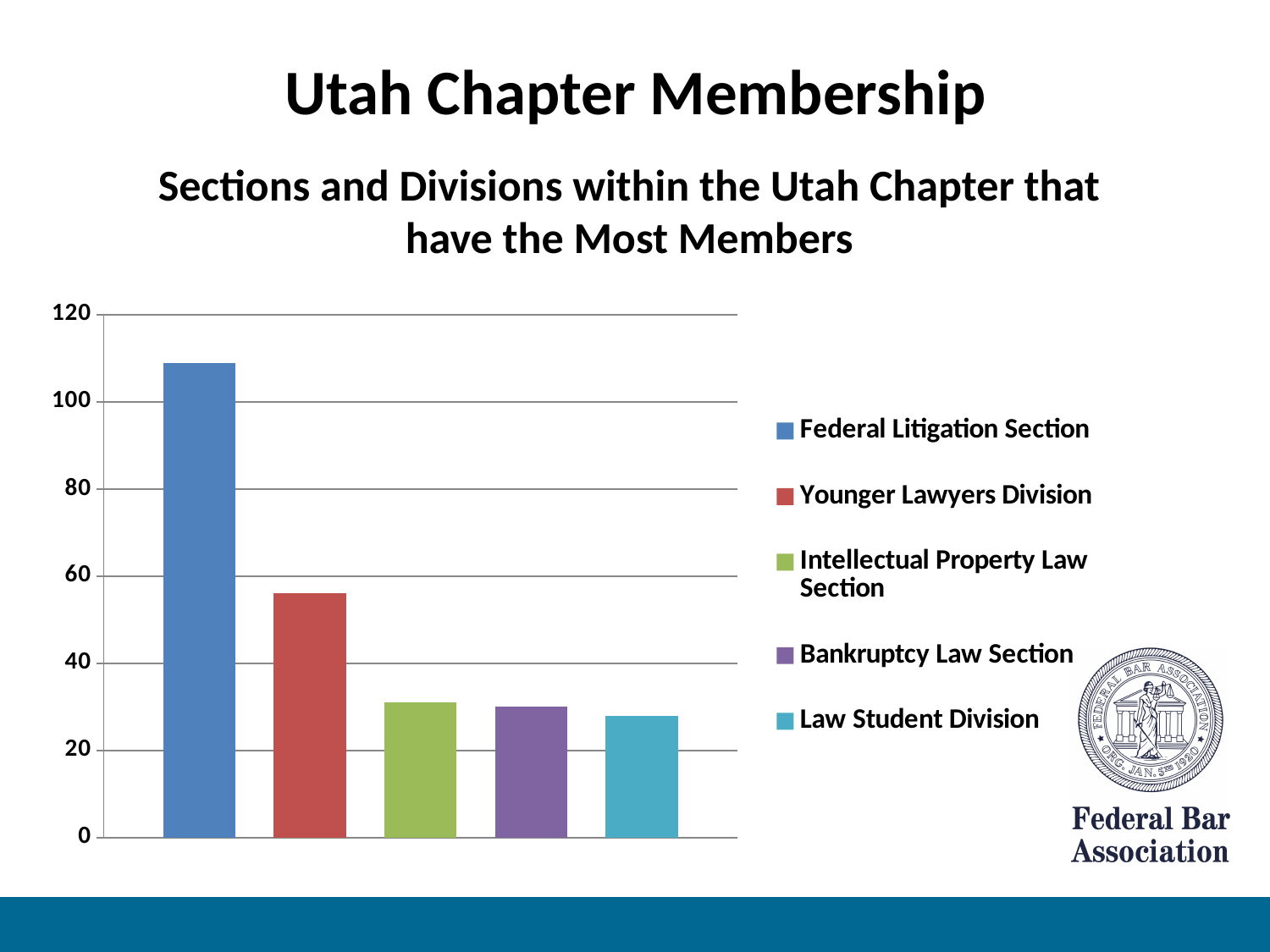
Is the value for Younger Lawyers Division greater or less than 40? greater What kind of chart is shown on the slide? bar chart Is the value for Younger Lawyers Division greater or less than 60? less How many entries does the chart's legend list? 5 Is the value for Intellectual Property Law Section greater or less than 20? greater Which section or division has the highest membership in the chart? Federal Litigation Section Do the bar values rise or fall from left to right across the chart? fall How many bars are plotted in the chart? 5 What colour is the bar for Younger Lawyers Division? red Which has more members, Federal Litigation Section or Younger Lawyers Division? Federal Litigation Section